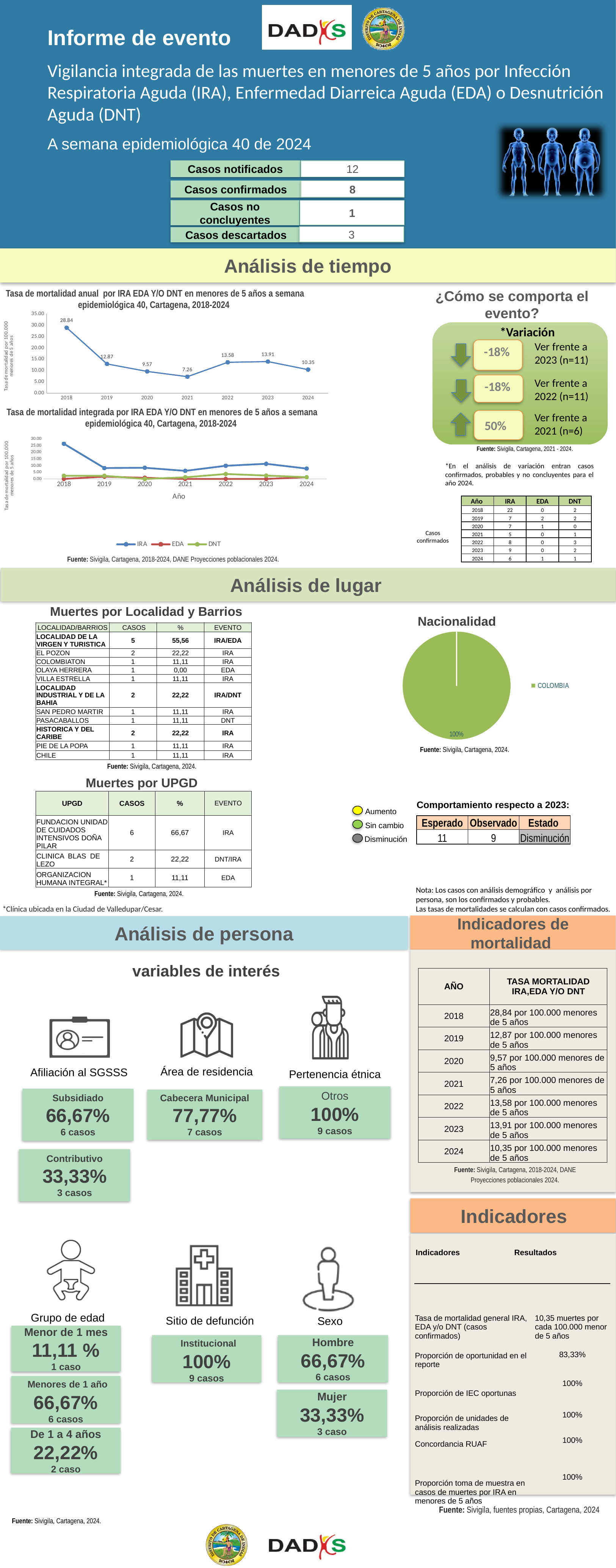
In the chart 'Tasa de mortalidad anual por IRA EDA Y/O DNT en menores de 5 años', which year has the larger value, 2019 or 2024? 2019 In the chart 'Tasa de mortalidad anual por IRA EDA Y/O DNT en menores de 5 años', which year has the highest value? 2018 In the chart 'Tasa de mortalidad anual por IRA EDA Y/O DNT en menores de 5 años', which year has the lowest value? 2021 What kind of chart is 'Tasa de mortalidad anual por IRA EDA Y/O DNT en menores de 5 años'? Line chart In the chart 'Tasa de mortalidad integrada por IRA EDA Y/O DNT en menores de 5 años', is the IRA value for 2018 greater or less than 20.00? greater In the chart 'Tasa de mortalidad anual por IRA EDA Y/O DNT en menores de 5 años', what is the value for 2018? 28.84 In the chart 'Tasa de mortalidad anual por IRA EDA Y/O DNT en menores de 5 años', what is the value for 2024? 10.35 In the chart 'Tasa de mortalidad anual por IRA EDA Y/O DNT en menores de 5 años', do the values rise or fall from 2018 to 2021? Fall In the pie chart 'Nacionalidad', what share does COLOMBIA have? 100% How many series does the legend list in the chart 'Tasa de mortalidad integrada por IRA EDA Y/O DNT en menores de 5 años'? 3 In the chart 'Tasa de mortalidad anual por IRA EDA Y/O DNT en menores de 5 años', what is the difference between the values for 2023 and 2022? 0.33 How many years are plotted in the chart 'Tasa de mortalidad anual por IRA EDA Y/O DNT en menores de 5 años'? 7